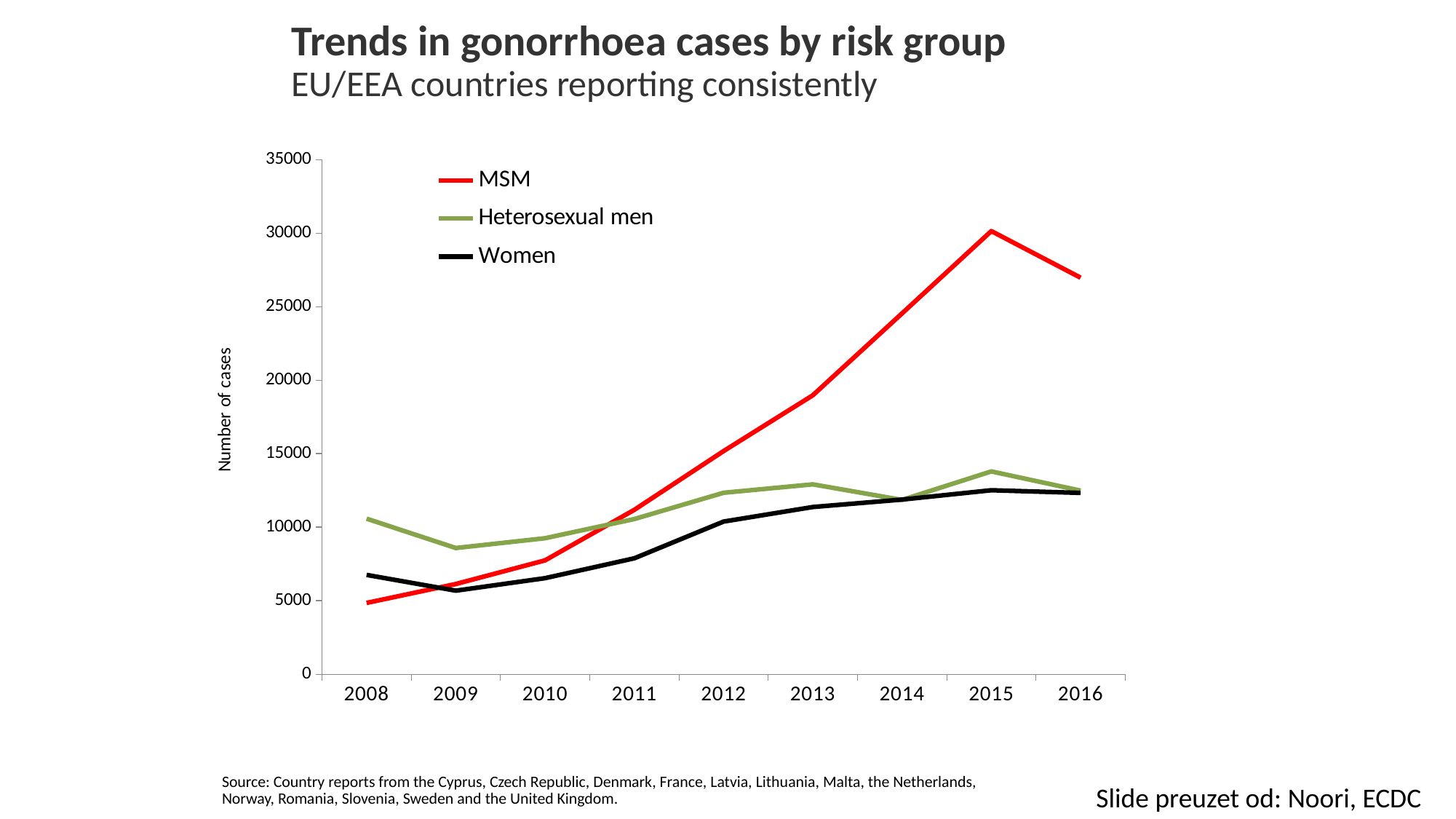
Is the value for Heterosexual men in 2009 greater or less than 10000? less Which risk group has the highest number of cases in 2016? MSM How many years are plotted along the x axis? 9 Is the value for Women in 2008 greater or less than 5000? greater Is the value for MSM in 2015 greater or less than 25000? greater Which is larger in 2008, the value for Heterosexual men or the value for Women? Heterosexual men Which risk group has the lowest number of cases in 2008? MSM Does the MSM line rise or fall between 2008 and 2015? Rises What is the label on the y axis? Number of cases How many series does the legend list? 3 In which year does the MSM line reach its peak? 2015 What kind of chart is shown on the slide? Line chart